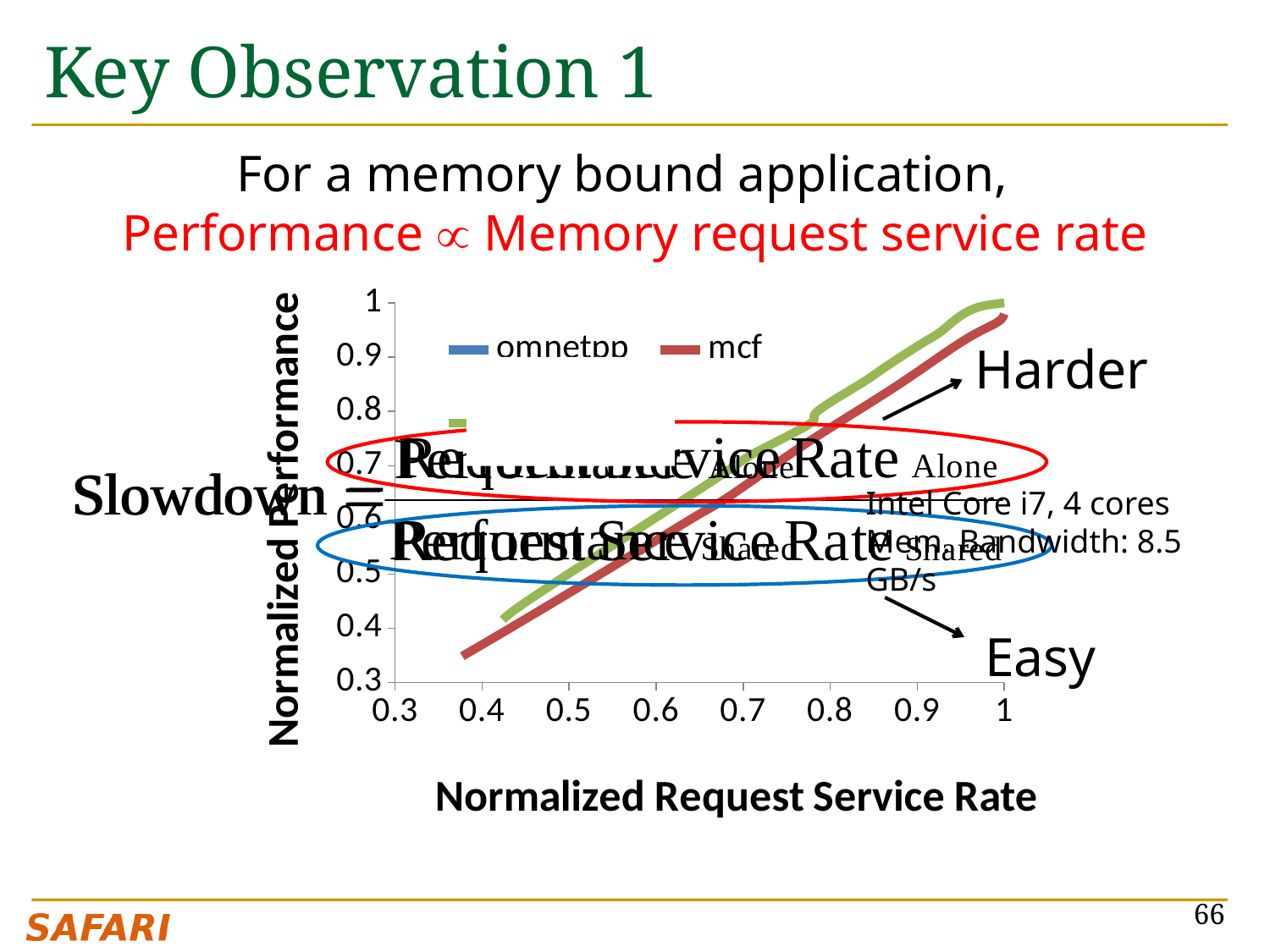
What kind of chart is shown on the slide? line chart What is the title of the x axis of the chart? Normalized Request Service Rate Which series are listed in the chart legend? omnetpp and mcf Is the Normalized Performance of mcf at a Normalized Request Service Rate of 0.7 greater or less than 0.6? greater Is the Normalized Performance of mcf at a Normalized Request Service Rate of 0.9 greater or less than 0.8? greater Is the Normalized Performance of mcf at a Normalized Request Service Rate of 1 greater or less than 0.9? greater Do the plotted lines rise or fall as Normalized Request Service Rate increases? rise How many series does the chart legend list? 2